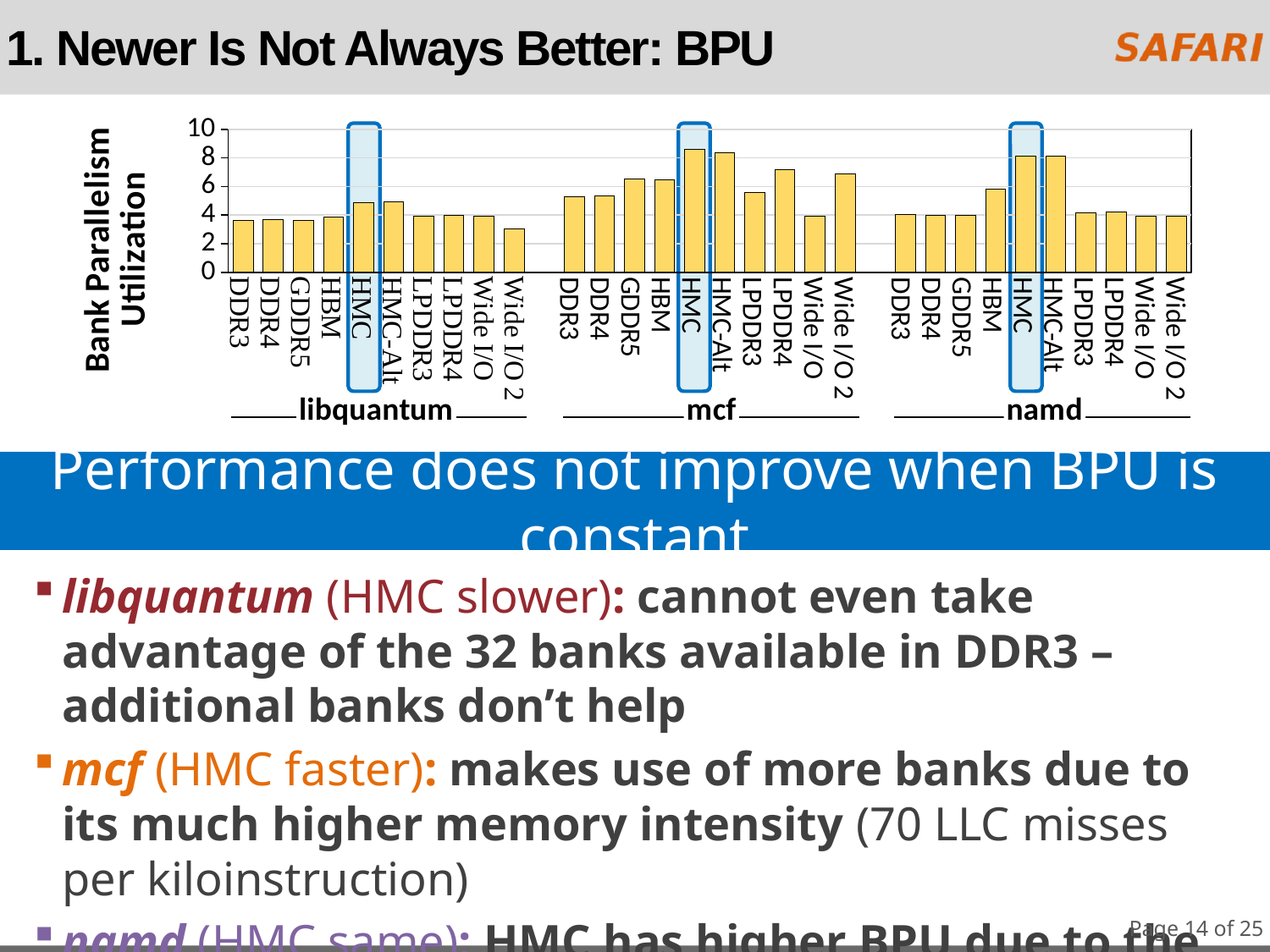
Within the mcf group, which memory type has the lowest Bank Parallelism Utilization? Wide I/O What is the label of the y axis of the chart? Bank Parallelism Utilization Is the Bank Parallelism Utilization for HBM in the namd group greater or less than 4? greater Is the Bank Parallelism Utilization for HMC in the mcf group greater or less than 8? greater Is the Bank Parallelism Utilization for Wide I/O 2 in the libquantum group greater or less than 4? less How many workload groups are shown along the x axis of the chart? 3 How many memory types (bars) are plotted for the mcf workload? 10 Within the libquantum group, which memory type has the lowest Bank Parallelism Utilization? Wide I/O 2 What kind of chart is shown on the slide? bar chart Which memory type is highlighted with a blue box in each workload group? HMC Which has the higher Bank Parallelism Utilization: HMC in the mcf group or HMC in the libquantum group? HMC in the mcf group